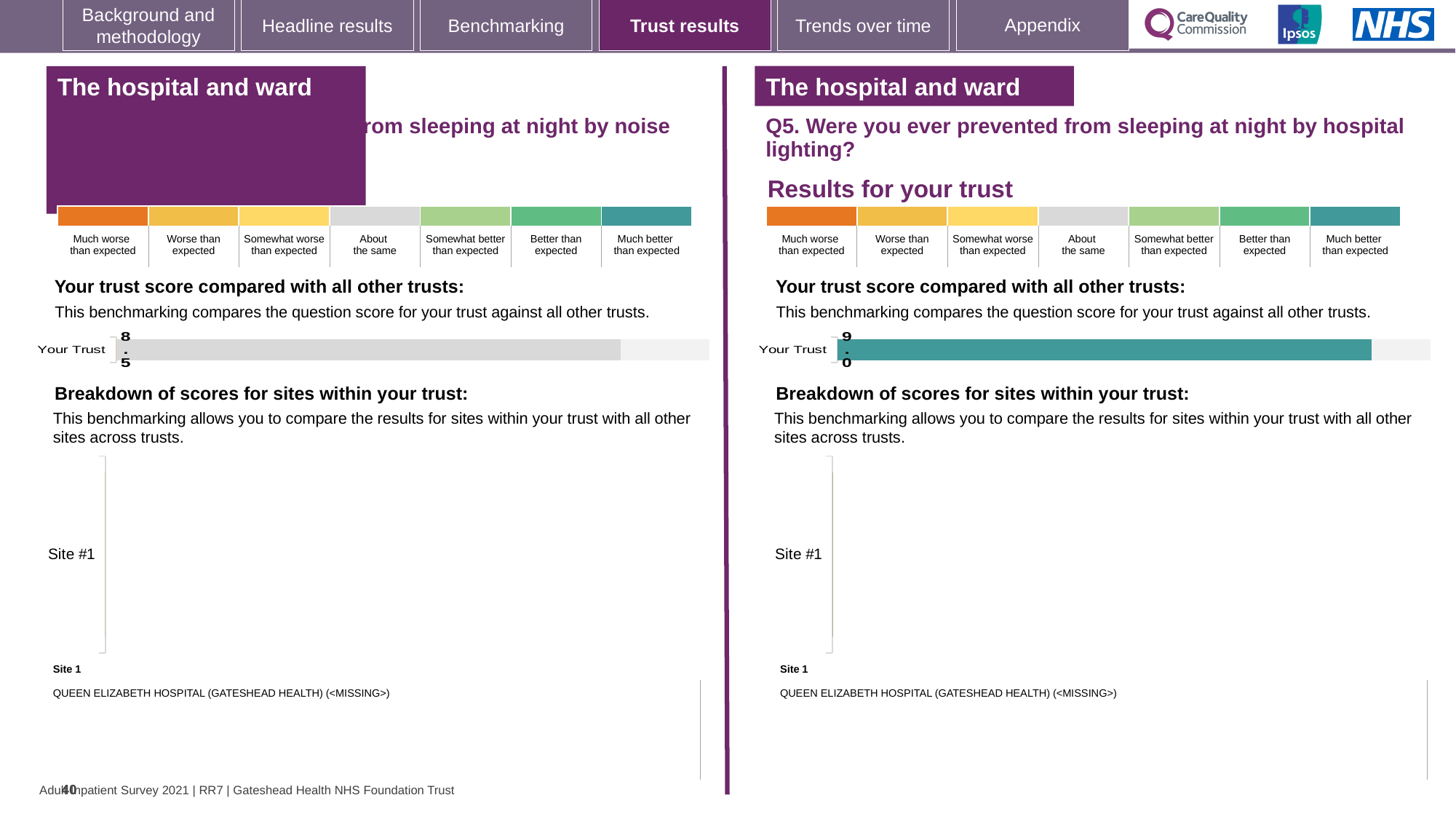
What is the difference between the Your Trust score on the right chart (9.0) and the Your Trust score on the left chart (8.5)? 0.5 Which question has the higher Your Trust score: the left chart (noise) or the right chart (Q5, hospital lighting)? Q5, hospital lighting (right chart) Which benchmark category in the colour key matches the grey colour of the Your Trust bar on the left chart? About the same On the right chart (Q5, hospital lighting), is the Your Trust score greater or less than 8? greater On the left chart (sleeping at night by noise), what is the score shown for Your Trust? 8.5 Which benchmark category in the colour key matches the teal colour of the Your Trust bar on the right chart? Much better than expected How many bars are plotted in the 'Your trust score compared with all other trusts' chart on the right side? 1 What kind of chart is used to show the Your Trust score on each side of the slide? Bar chart On the right chart (Q5, hospital lighting), what is the score shown for Your Trust? 9.0